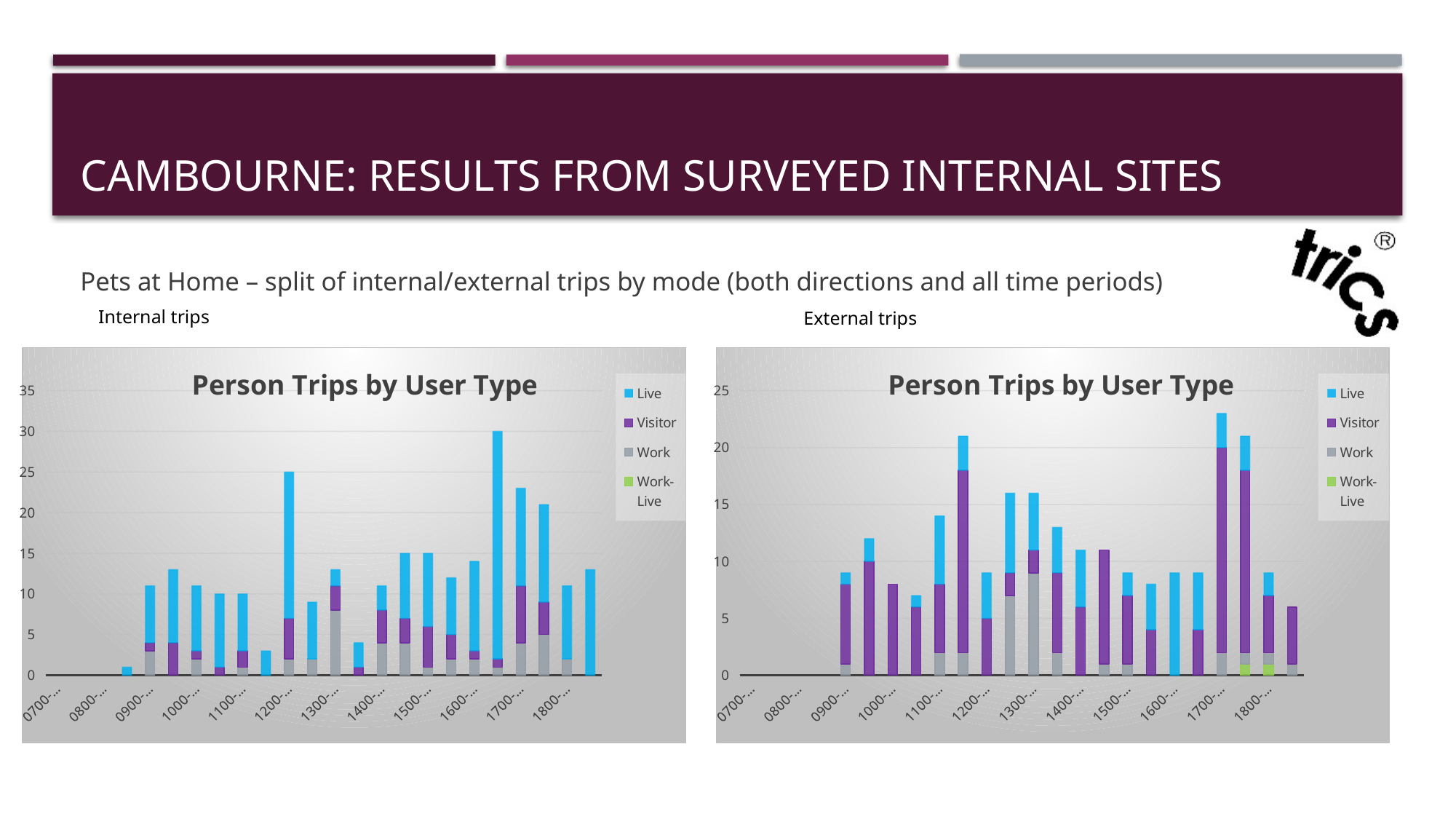
In the External trips chart, is the tallest bar greater or less than 20? greater What type of chart is the Internal trips chart on the left? bar chart Which chart has the taller tallest bar, the Internal trips chart or the External trips chart? Internal trips chart How many series does the legend of the External trips chart list? 4 In the Internal trips chart, is the tallest bar greater or less than 25? greater What is the title of the Internal trips chart on the left? Person Trips by User Type What type of chart is the External trips chart on the right? bar chart In the External trips chart, which series is shown in purple? Visitor In the Internal trips chart, is the tallest bar greater or less than 35? less How many series does the legend of the Internal trips chart list? 4